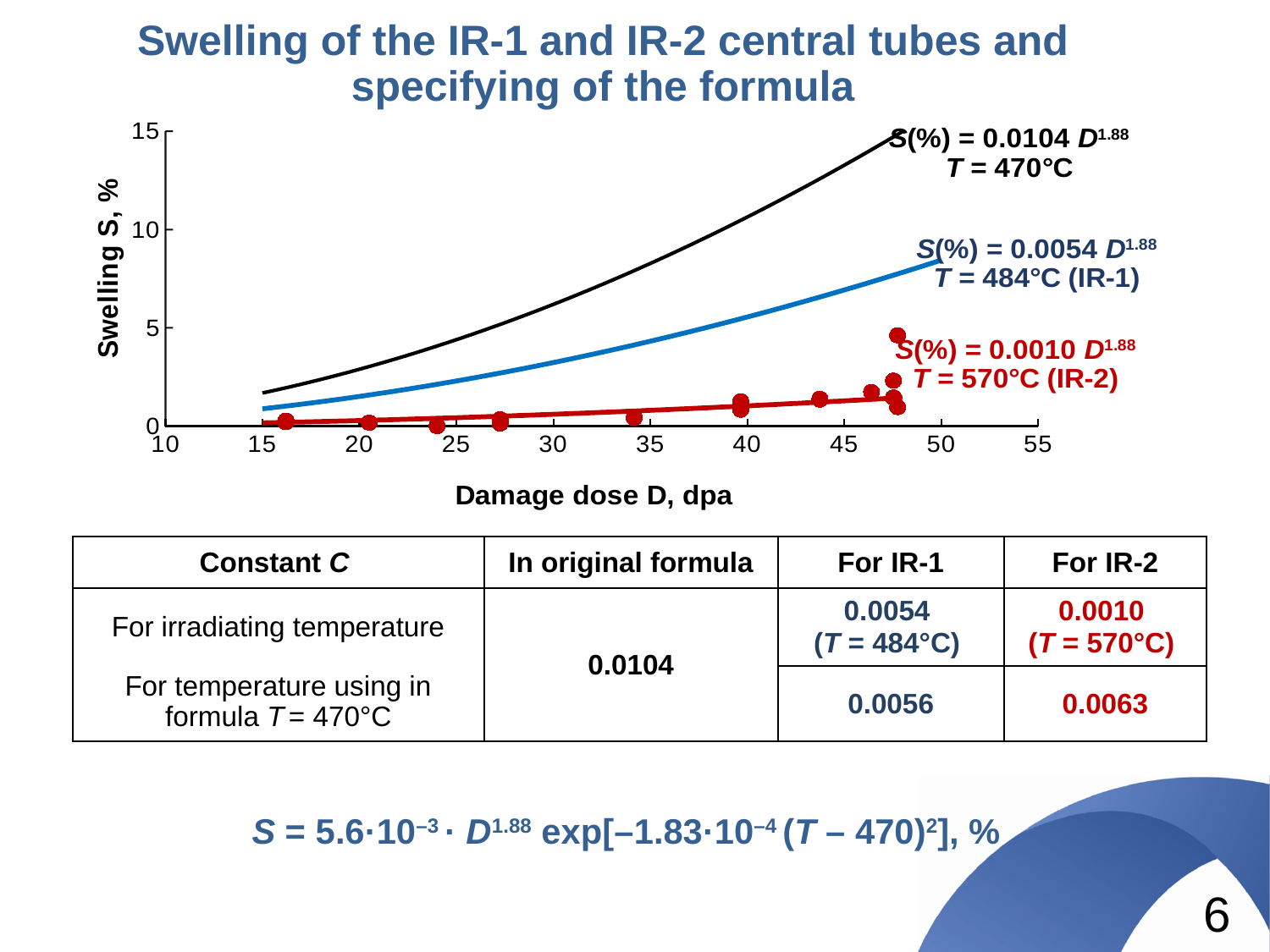
Which curve is higher at a damage dose of 40 dpa, the blue curve (IR-1) or the red curve (IR-2)? The blue curve (IR-1) What is the label of the x axis of the chart? Damage dose D, dpa What constant appears in the formula labelling the blue curve for IR-1? 0.0054 Is the value of the blue curve (T = 484°C, IR-1) at a damage dose of 50 dpa greater or less than 10? less What is the label of the y axis of the chart? Swelling S, % How many curves are plotted on the chart? 3 Is the value of the black curve (T = 470°C) at a damage dose of 50 dpa greater or less than 10? greater Which curve is the lowest on the chart? The red curve, T = 570°C (IR-2) What kind of chart is shown on the slide? Line chart Which curve is the highest on the chart? The black curve, T = 470°C Does swelling rise or fall as the damage dose increases along the x axis? Rise Is the value of the red curve (T = 570°C, IR-2) at a damage dose of 45 dpa greater or less than 5? less